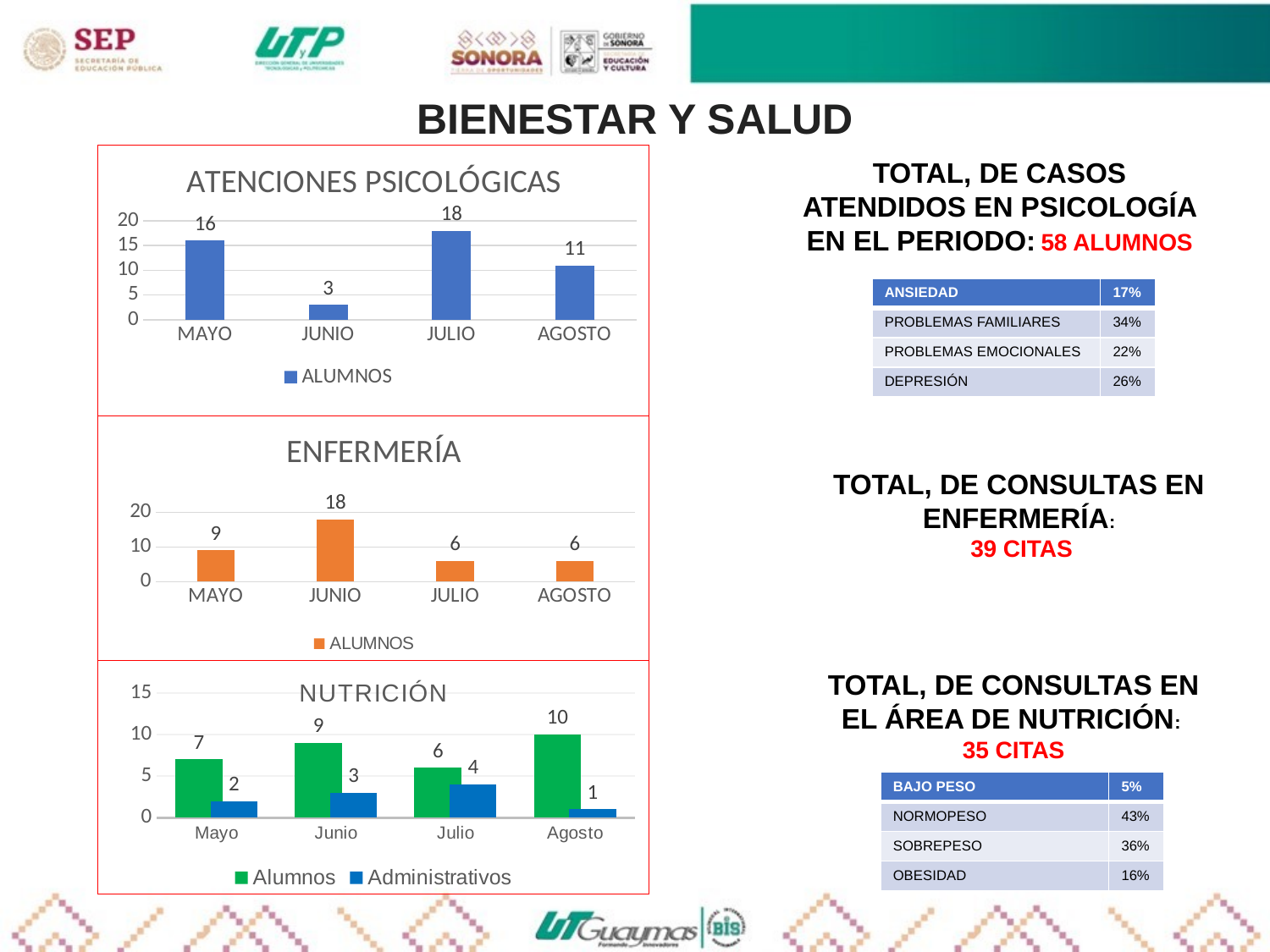
In the ENFERMERÍA chart, how many months are shown on the x axis? 4 In the ATENCIONES PSICOLÓGICAS chart, what is the difference between MAYO and AGOSTO? 5 In the ATENCIONES PSICOLÓGICAS chart, which month has the lowest value? JUNIO What kind of chart is the ENFERMERÍA chart? Bar chart In the NUTRICIÓN chart, is the value for Alumnos in Mayo larger than the value for Administrativos in Mayo? Yes In the NUTRICIÓN chart, what is the value for Administrativos in Julio? 4 In the NUTRICIÓN chart, what is the difference between Alumnos and Administrativos in Agosto? 9 In the ATENCIONES PSICOLÓGICAS chart, what is the value for JULIO? 18 In the ENFERMERÍA chart, what is the value for JUNIO? 18 In the NUTRICIÓN chart, how many series does the legend list? 2 In the ENFERMERÍA chart, which month has the highest value? JUNIO In the NUTRICIÓN chart, which month has the highest value for Alumnos? Agosto